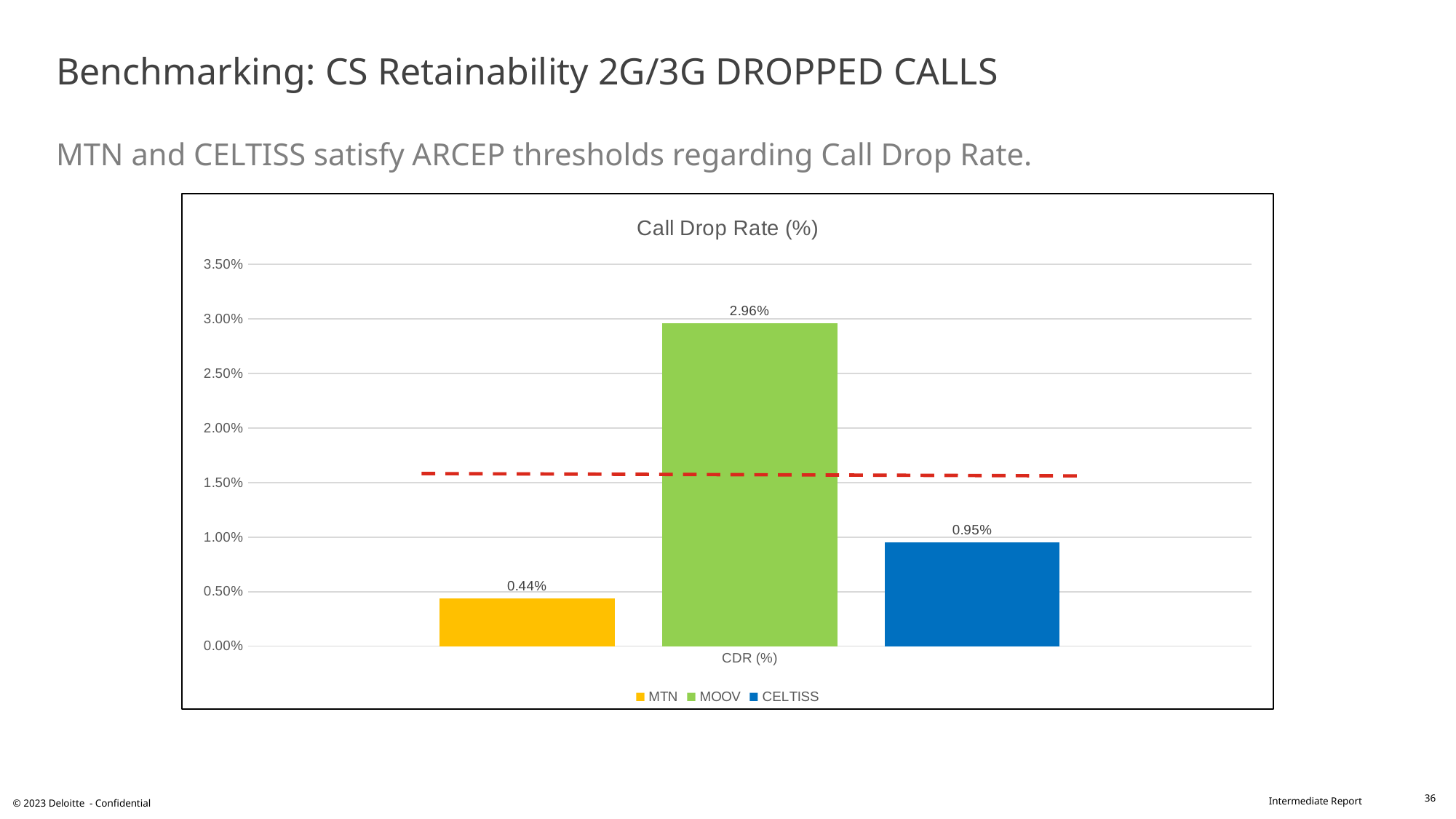
What is the difference between the Call Drop Rate of CELTISS and MTN? 0.51% Which operator has the lowest Call Drop Rate? MTN What is the Call Drop Rate for CELTISS? 0.95% Which has a larger Call Drop Rate, MTN or CELTISS? CELTISS What is the Call Drop Rate for MOOV? 2.96% What is the title of the chart? Call Drop Rate (%) Which operator has the highest Call Drop Rate? MOOV Is the Call Drop Rate for MOOV greater or less than 2.50%? greater What is the Call Drop Rate for MTN? 0.44% How many series does the legend list? 3 What is the difference between the Call Drop Rate of MOOV and CELTISS? 2.01% What kind of chart is shown on the slide? Bar chart